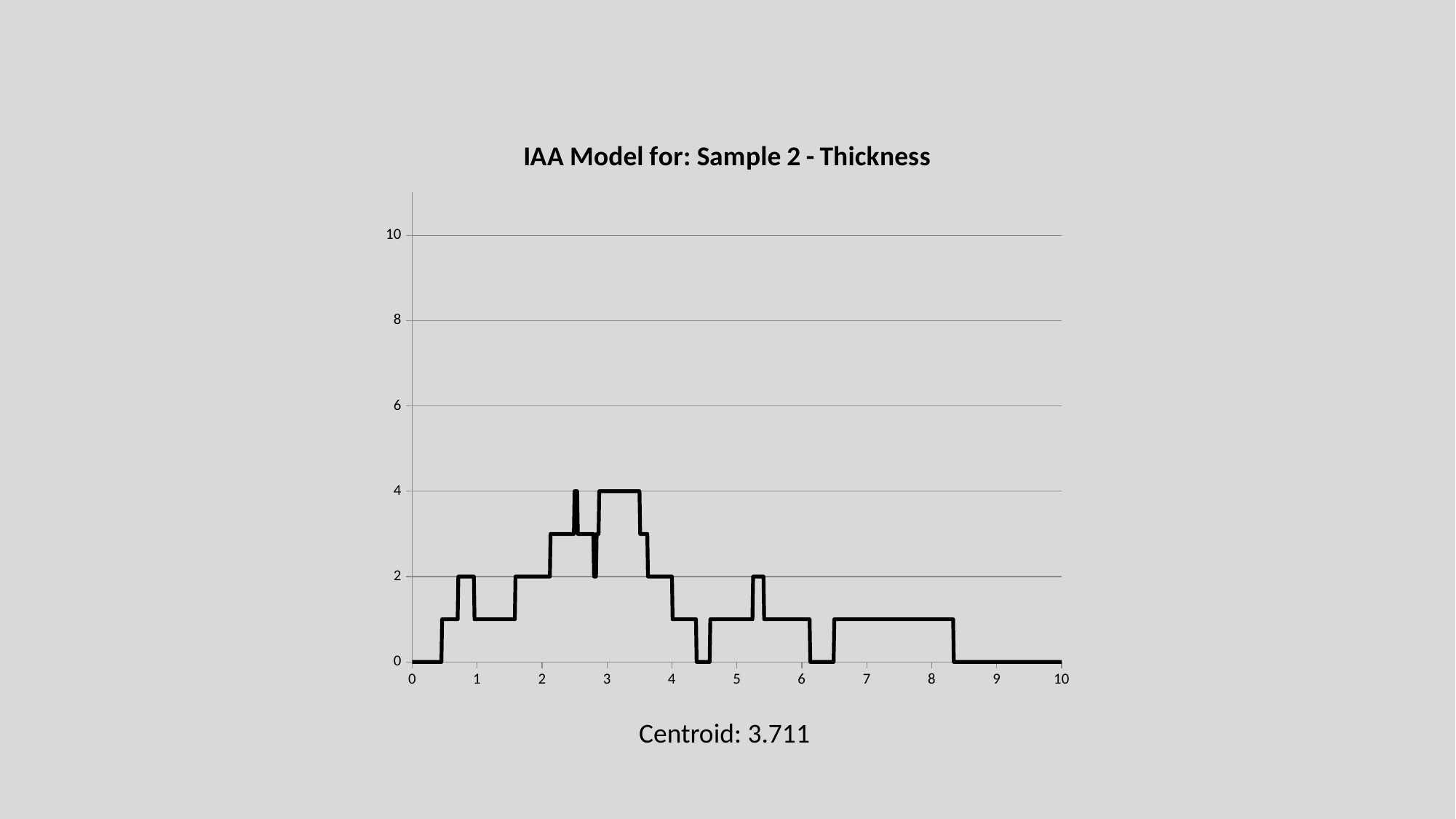
What is the value of the line at x = 3.2? 4 What is the title of the chart? IAA Model for: Sample 2 - Thickness What is the highest value the line reaches on the y axis? 4 Is the value of the line at x = 3 greater or less than 2? greater What kind of chart is shown on the slide? line chart What centroid value is stated below the chart? 3.711 What is the value of the line at x = 9? 0 Is the value of the line at x = 7.5 greater or less than 2? less What is the highest tick label shown on the y axis? 10 What is the value of the line at x = 1.8? 2 What is the value of the line at x = 0.2? 0